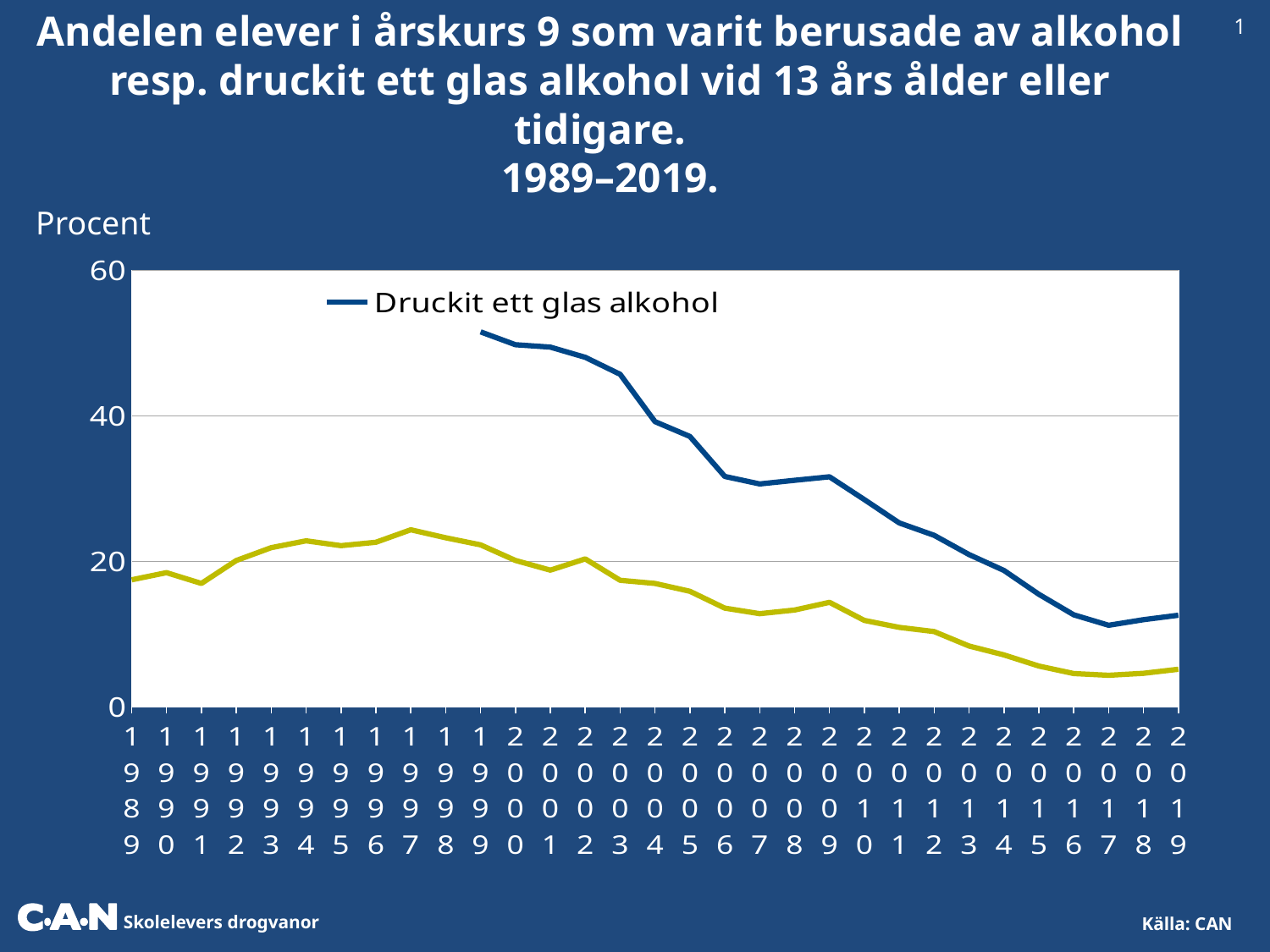
What label is shown above the y axis? Procent Is the value for Druckit ett glas alkohol in 2019 greater or less than 20? less What kind of chart is shown on the slide? line chart What is the name of the series listed in the legend? Druckit ett glas alkohol Does the Druckit ett glas alkohol series rise or fall from 1999 to 2019? fall Is the value of the yellow-green line in 2015 greater or less than 20? less How many series does the chart legend list? 1 Which is larger for Druckit ett glas alkohol, the value in 1999 or the value in 2019? 1999 In which year is the Druckit ett glas alkohol series at its highest? 1999 How many years are shown on the x axis? 31 Is the value for Druckit ett glas alkohol in 1999 greater or less than 40? greater